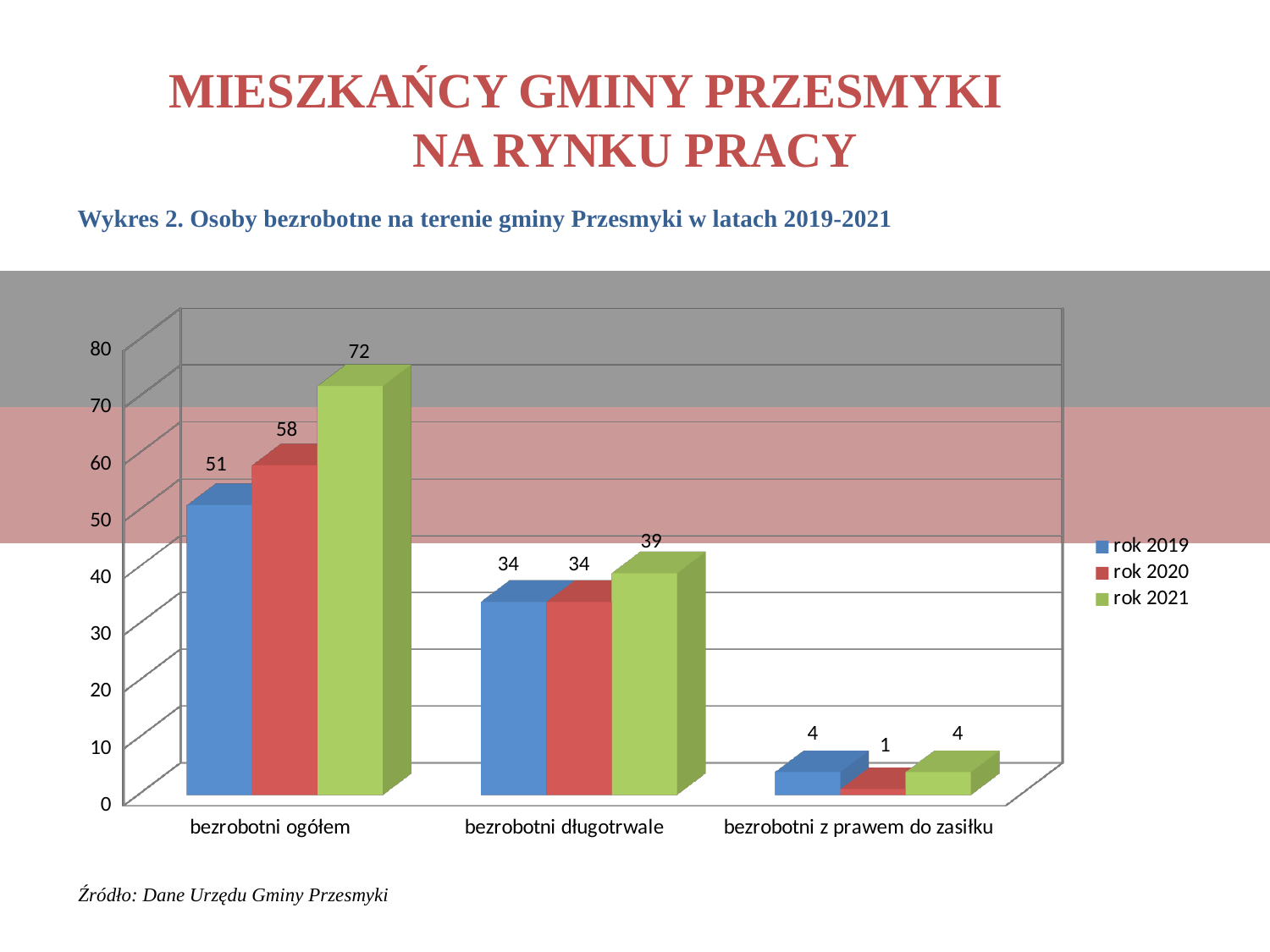
Which is larger for 'bezrobotni ogółem': the rok 2020 value or the rok 2019 value? rok 2020 What is the difference between the rok 2021 and rok 2019 values for 'bezrobotni ogółem'? 21 What is the value for 'bezrobotni długotrwale' in rok 2020? 34 Do the values for rok 2021 rise or fall from left to right across the categories? fall Which series is shown in green in the legend? rok 2021 What is the value for 'bezrobotni z prawem do zasiłku' in rok 2020? 1 Which category has the lowest value in rok 2021? bezrobotni z prawem do zasiłku What is the value for 'bezrobotni ogółem' in rok 2021? 72 How many categories are shown on the x axis? 3 What kind of chart is shown on the slide? bar chart Which category has the highest value in rok 2019? bezrobotni ogółem How many series does the legend list? 3